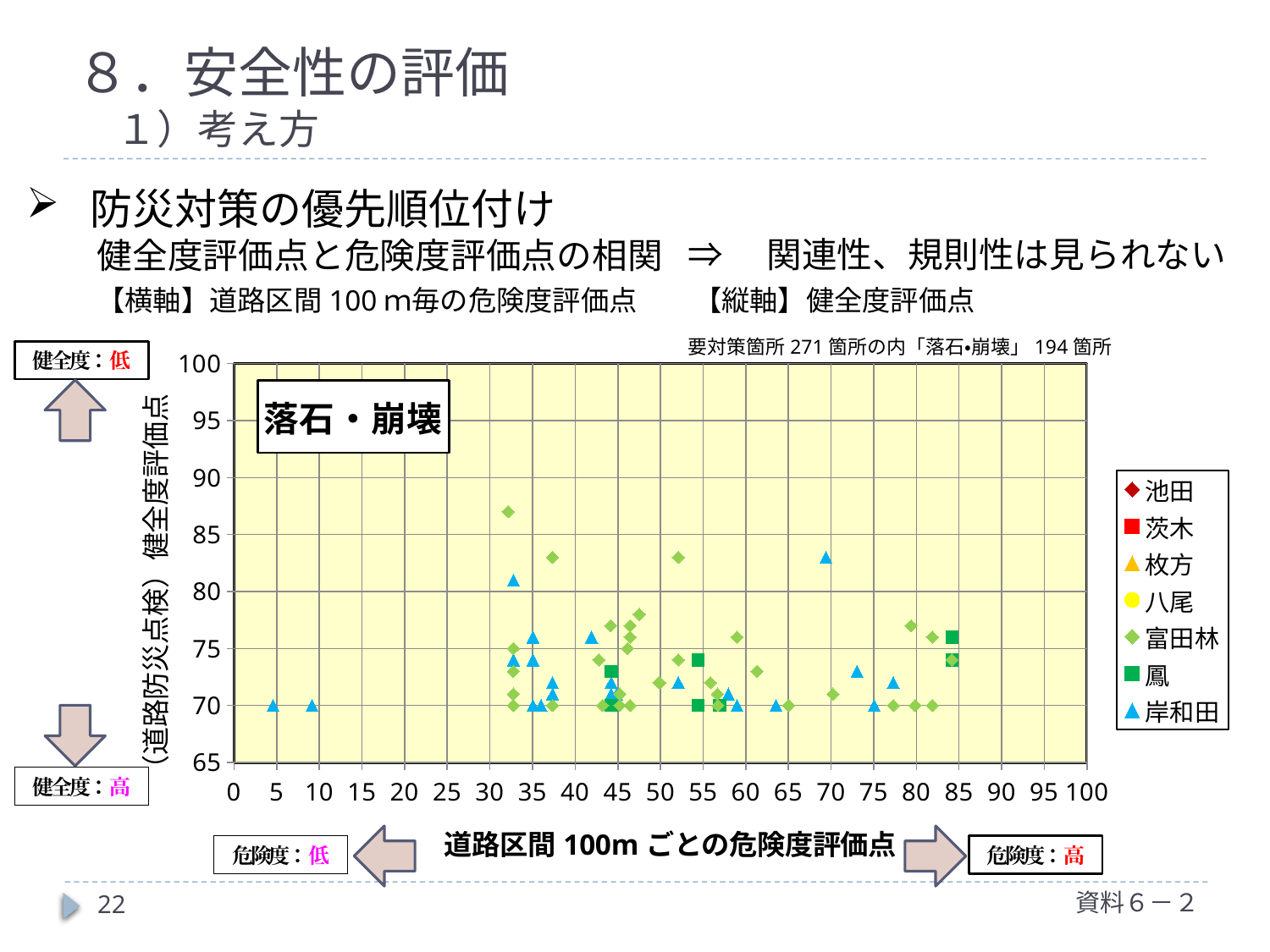
Which series has the highest plotted point on the vertical axis? 富田林 Is the horizontal-axis value of the rightmost plotted points greater or less than 80? greater Is the vertical-axis value of the leftmost plotted point (near 5 on the horizontal axis) greater or less than 75? less Which has a higher vertical-axis value: the highest 富田林 point or the highest 岸和田 point? the highest 富田林 point Is the highest 岸和田 point greater or less than 80 on the vertical axis? greater Which series is shown with blue triangle markers in the legend? 岸和田 Which series has more plotted points, 富田林 or 鳳? 富田林 What is the title shown inside the chart plot area? 落石・崩壊 How many series does the chart legend list? 7 What kind of chart is shown on the slide? scatter chart